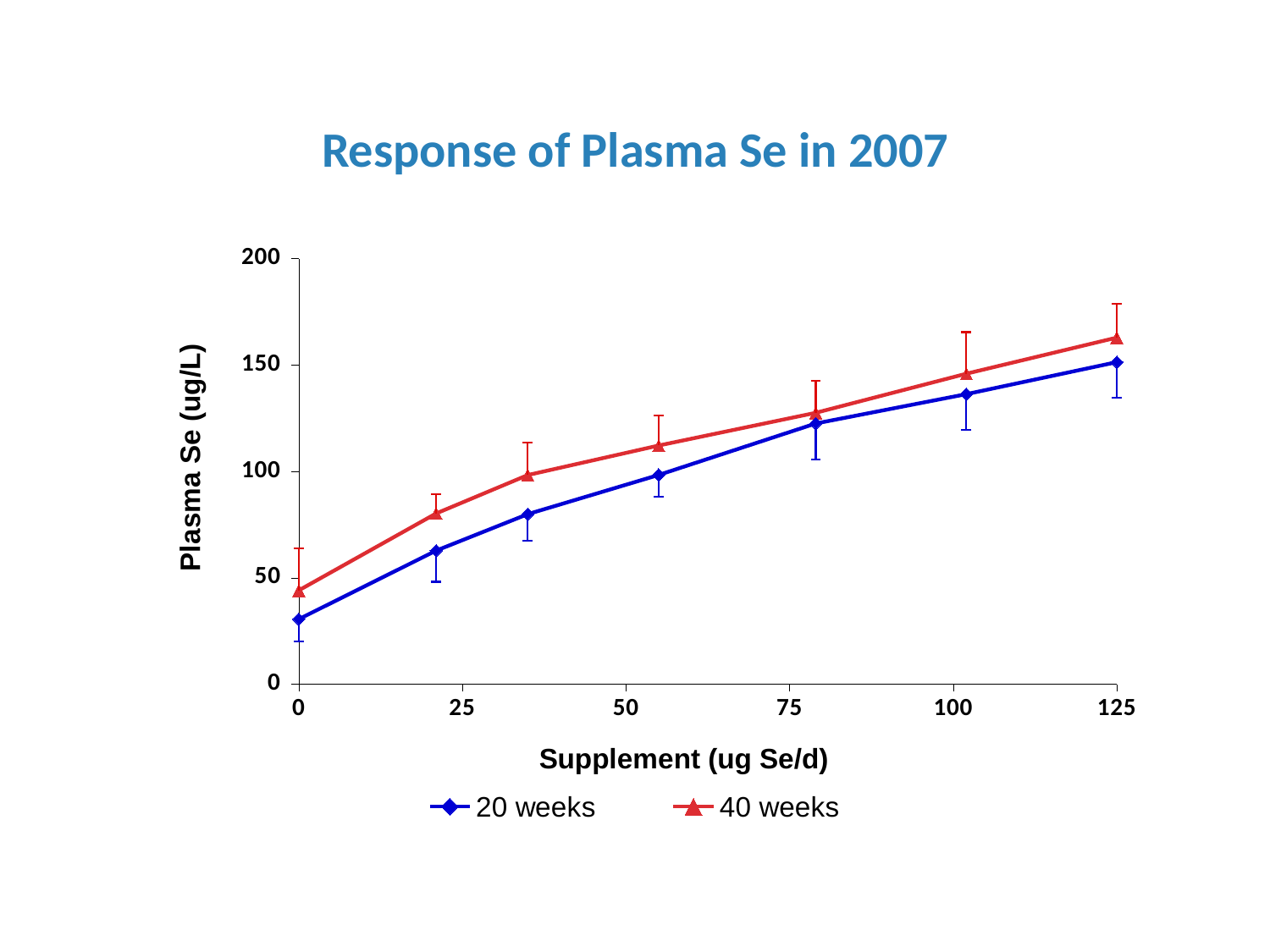
Is the 20 weeks value at a supplement of about 100 ug Se/d greater or less than 100? greater What is the title of the chart? Response of Plasma Se in 2007 What kind of chart is shown on the slide? line chart How many series does the legend list? 2 At a supplement of 0 ug Se/d, which series has the higher plasma Se value, 20 weeks or 40 weeks? 40 weeks How many data points are plotted for the 20 weeks series? 7 Is the 20 weeks value at a supplement of 0 ug Se/d greater or less than 50? less Do the plasma Se values for the 40 weeks series rise or fall as the supplement dose increases? rise Is the 40 weeks value at a supplement of 125 ug Se/d greater or less than 150? greater At a supplement of 125 ug Se/d, which series has the higher plasma Se value, 20 weeks or 40 weeks? 40 weeks What is the label of the y axis? Plasma Se (ug/L)